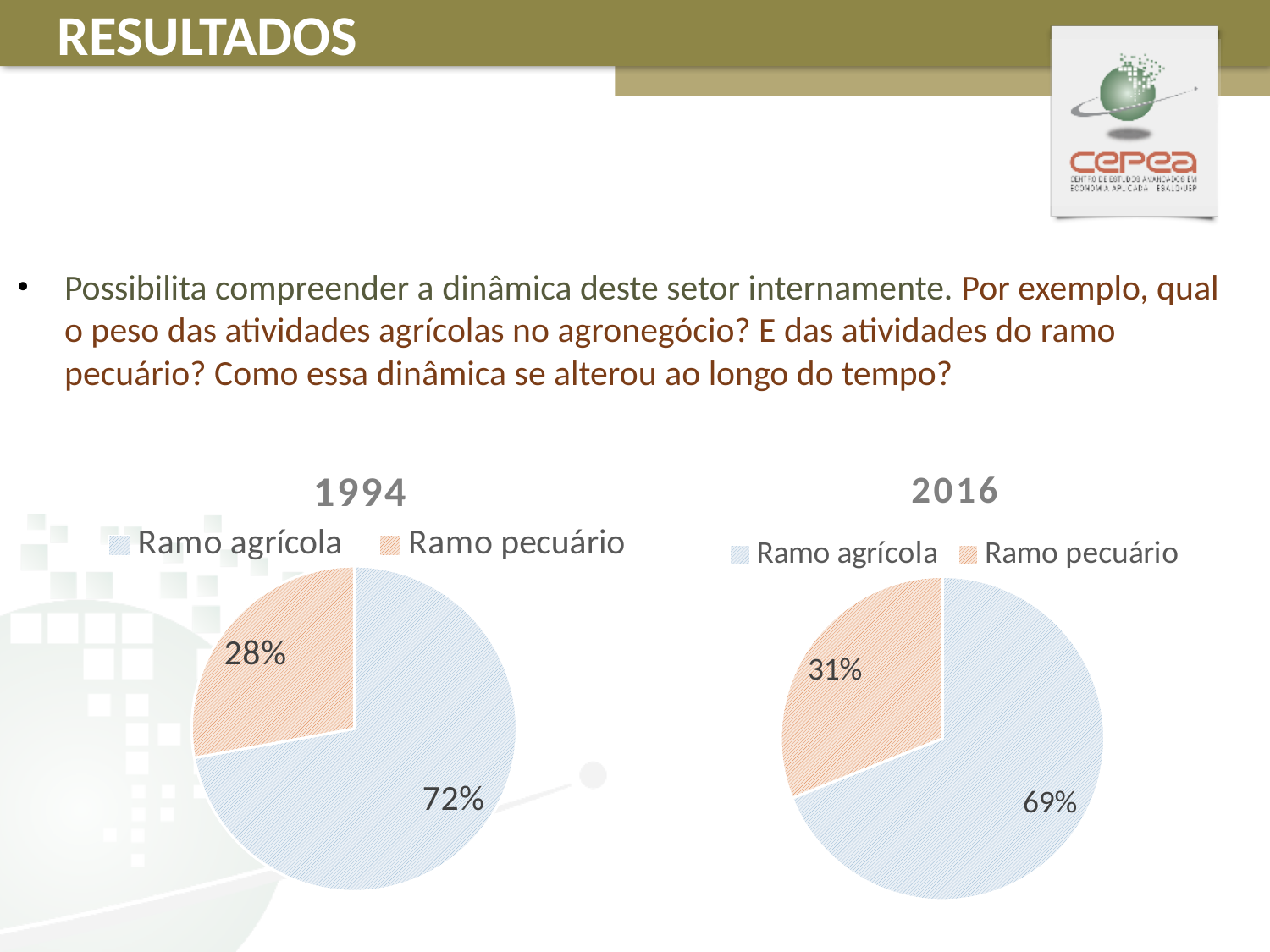
In the 2016 chart, which category has the smallest slice? Ramo pecuário In the 2016 chart, what share does Ramo pecuário have? 31% In the 1994 chart, what share does Ramo pecuário have? 28% In the 1994 chart, which category has the largest slice? Ramo agrícola How many categories does the 2016 chart show? 2 In the 1994 chart, what is the difference between the Ramo agrícola and Ramo pecuário shares? 44% Is the Ramo pecuário share larger in the 1994 chart or the 2016 chart? 2016 In the 2016 chart, what share does Ramo agrícola have? 69% What is the title of the chart on the right? 2016 In the 1994 chart, what share does Ramo agrícola have? 72% In the 2016 chart, what is the difference between the Ramo agrícola and Ramo pecuário shares? 38% What kind of chart is the 1994 chart? Pie chart